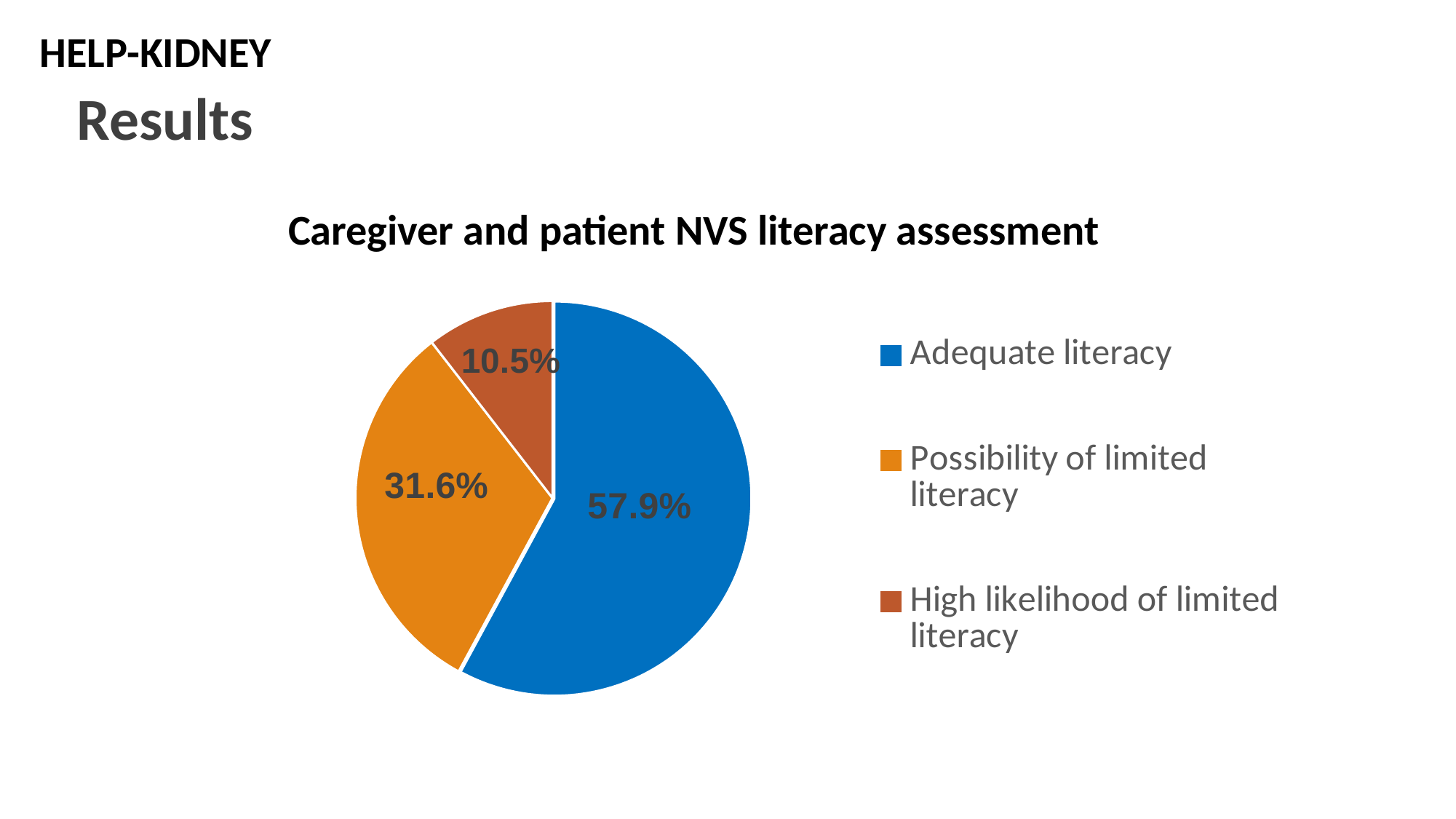
What percentage of the pie is labelled High likelihood of limited literacy? 10.5% How many categories does the pie chart show? 3 Which is larger: the slice for Possibility of limited literacy or the slice for High likelihood of limited literacy? Possibility of limited literacy What percentage of the pie is labelled Adequate literacy? 57.9% What is the difference in percentage points between the Adequate literacy slice and the Possibility of limited literacy slice? 26.3 What percentage of the pie is labelled Possibility of limited literacy? 31.6% Which category has the smallest slice of the pie? High likelihood of limited literacy What is the title of the chart? Caregiver and patient NVS literacy assessment Which category has the largest slice of the pie? Adequate literacy What colour is the slice for Adequate literacy? Blue What is the combined share of the two limited literacy categories (Possibility of limited literacy and High likelihood of limited literacy)? 42.1% What type of chart is shown on the slide? Pie chart